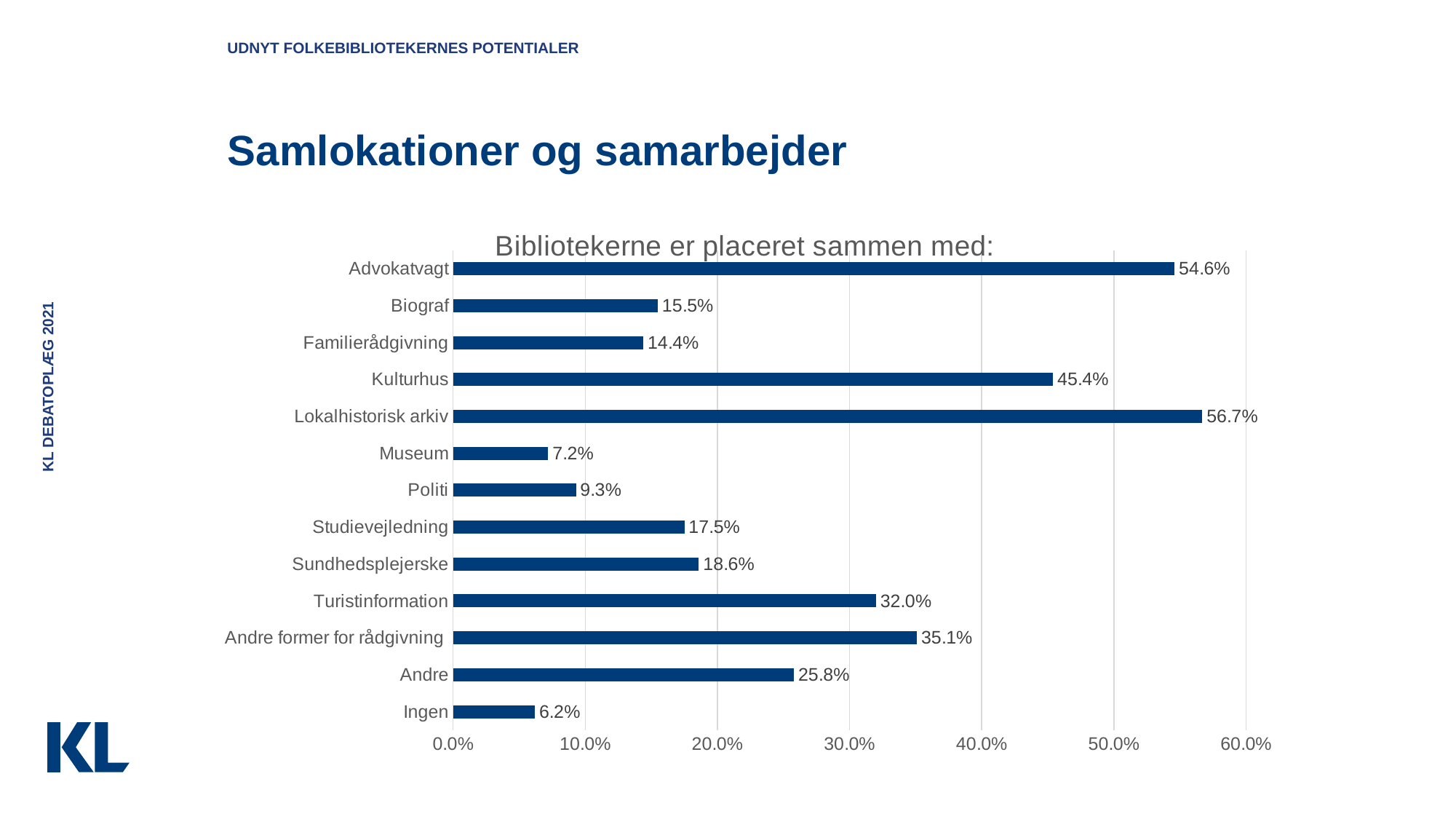
How many categories are shown in the chart? 13 What is the difference between the values for Andre former for rådgivning and Andre? 9.3% What is the value for Museum? 7.2% What is the difference between the values for Lokalhistorisk arkiv and Advokatvagt? 2.1% Which is larger, the value for Biograf or the value for Familierådgivning? Biograf What is the value for Turistinformation? 32.0% Is the value for Sundhedsplejerske greater or less than 20.0%? less What is the value for Kulturhus? 45.4% What kind of chart is shown on the slide? Bar chart What is the title of the chart? Bibliotekerne er placeret sammen med: Which category has the highest value? Lokalhistorisk arkiv Which category has the lowest value? Ingen